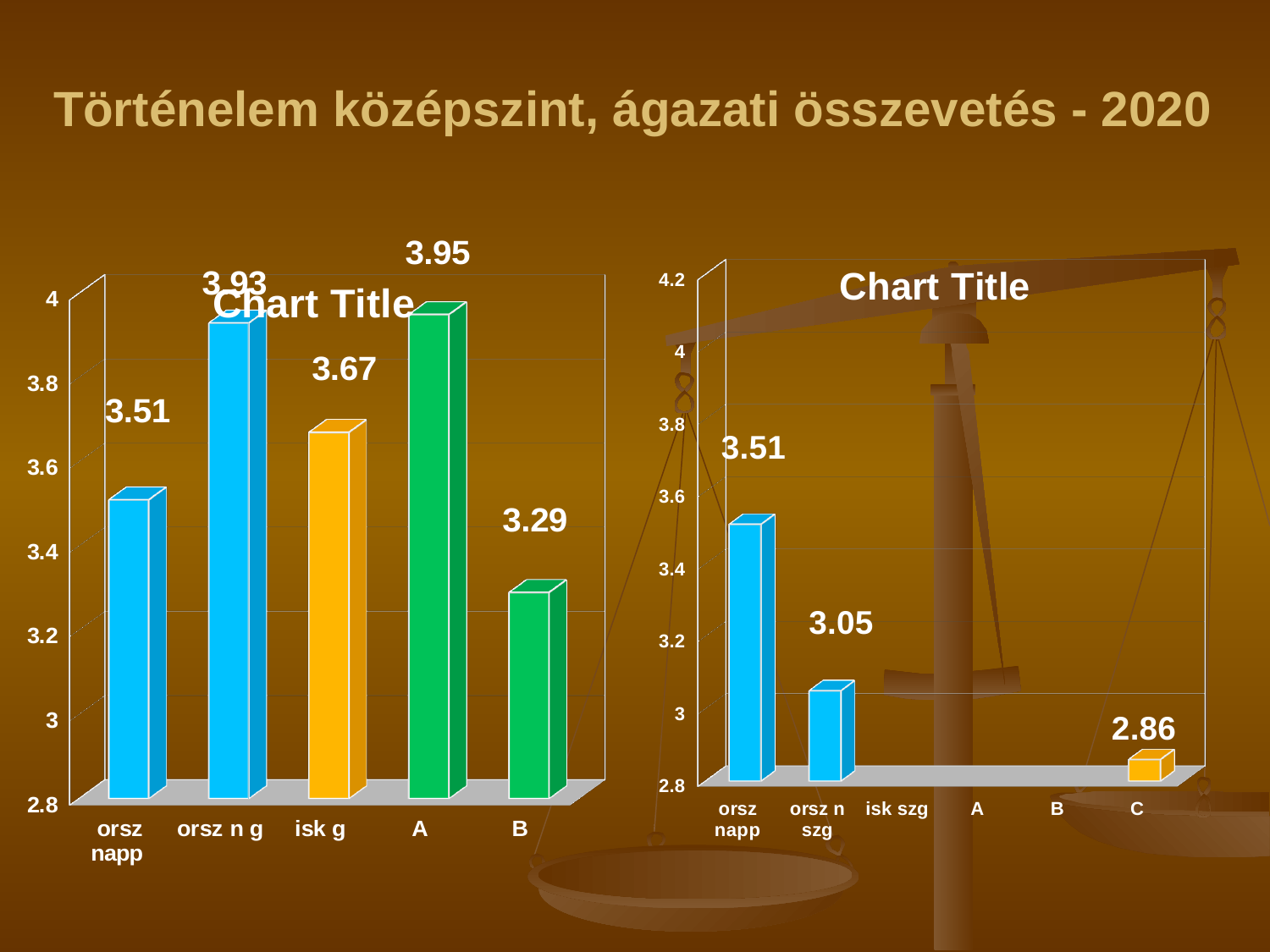
In the right chart, how many bars are plotted? 3 In the left chart, what is the value for B? 3.29 In the left chart, which category has the lowest value? B In the right chart, what is the value for orsz n szg? 3.05 What kind of chart is the left chart? Bar chart In the left chart, how many categories are shown on the x axis? 5 In the left chart, what is the value for isk g? 3.67 In the right chart, which category has the highest value? orsz napp In the left chart, which is larger, the value for isk g or the value for B? isk g In the right chart, what is the value for C? 2.86 In the right chart, what is the difference between the values for orsz napp and C? 0.65 In the left chart, what is the difference between the values for orsz n g and orsz napp? 0.42